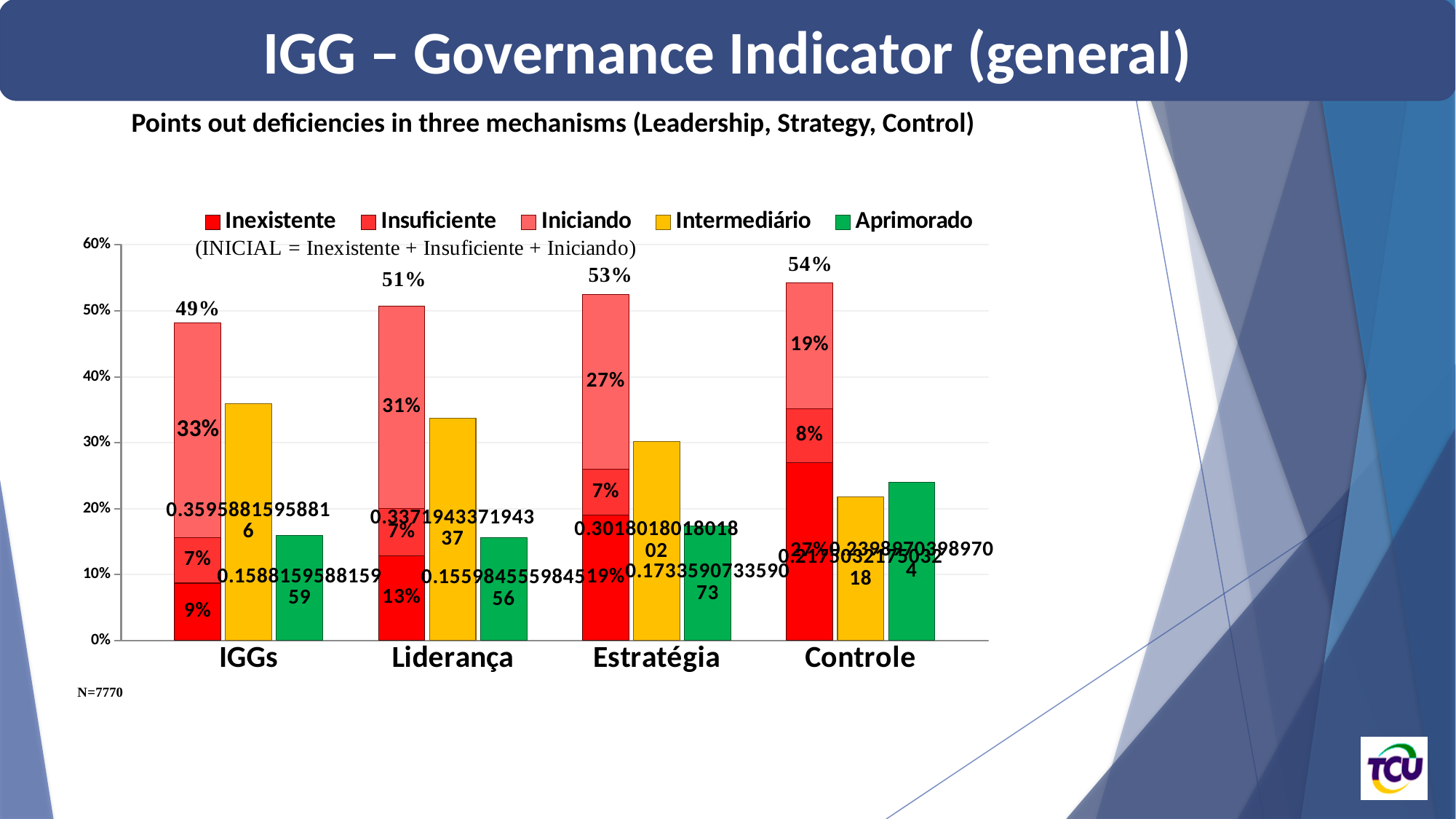
Which category has the lowest stacked INICIAL total? IGGs How many categories are shown on the x axis? 4 What is the Iniciando value for IGGs? 33% Which has the larger Inexistente value, Estratégia or Liderança? Estratégia Do the stacked INICIAL totals rise or fall from IGGs to Controle along the x axis? rise Is the Intermediário value for IGGs greater or less than 30%? greater Which category has the highest stacked INICIAL total? Controle What is the difference between the stacked INICIAL totals for Controle and IGGs? 5 percentage points What is the total of the stacked INICIAL bar for Liderança? 51% What is the Inexistente value for Controle? 27% What kind of chart is shown on the slide? bar chart How many series does the legend list? 5